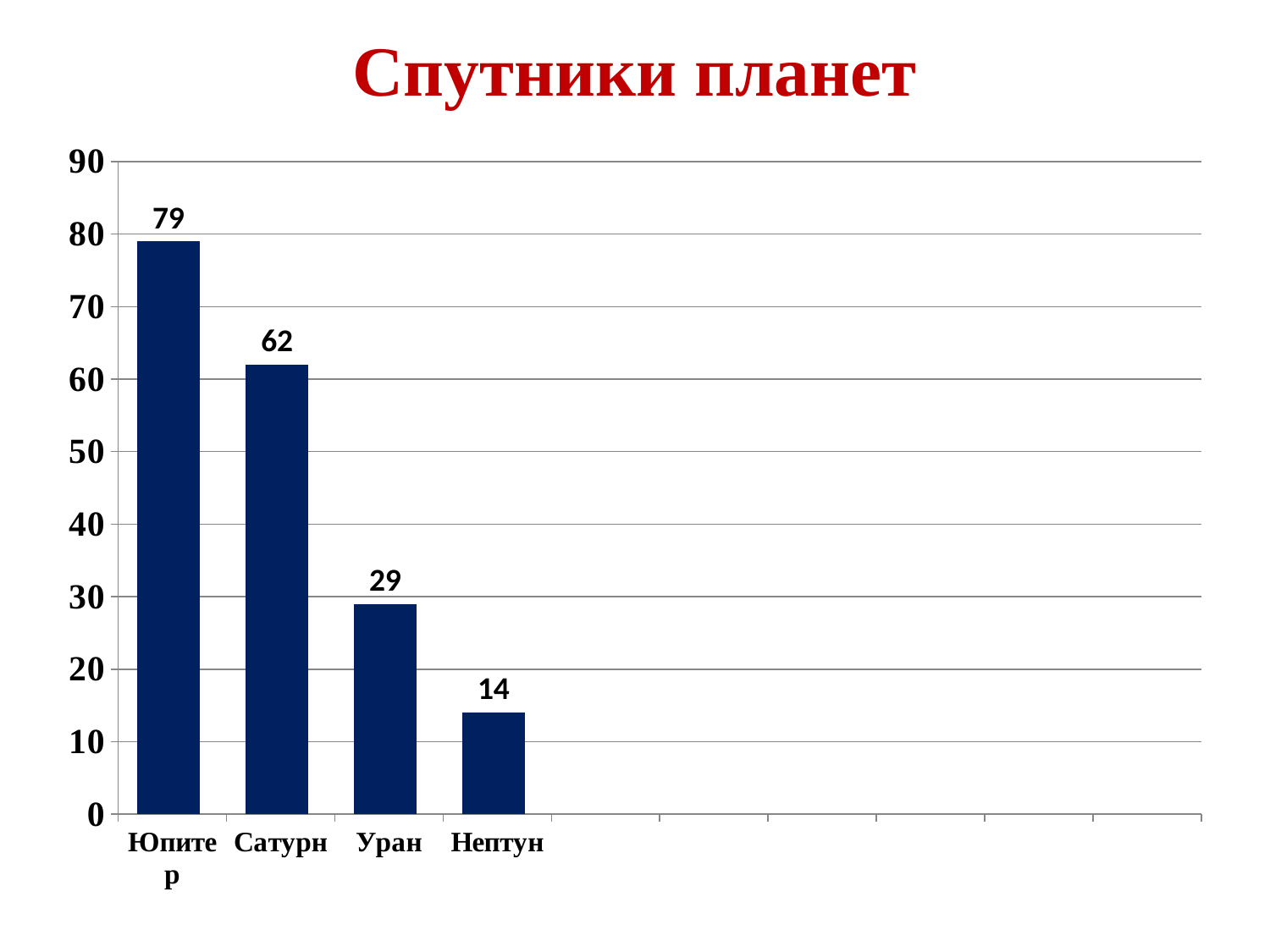
How many planets are shown on the chart? 4 What is the title of the chart? Спутники планет What is the value for Сатурн? 62 Which planet has the highest value? Юпитер What is the difference between the values for Уран and Нептун? 15 Which planet has the lowest value? Нептун Which is larger, the value for Сатурн or the value for Уран? Сатурн What is the value for Нептун? 14 What is the difference between the values for Юпитер and Сатурн? 17 What is the value for Юпитер? 79 What kind of chart is this? bar chart What is the value for Уран? 29